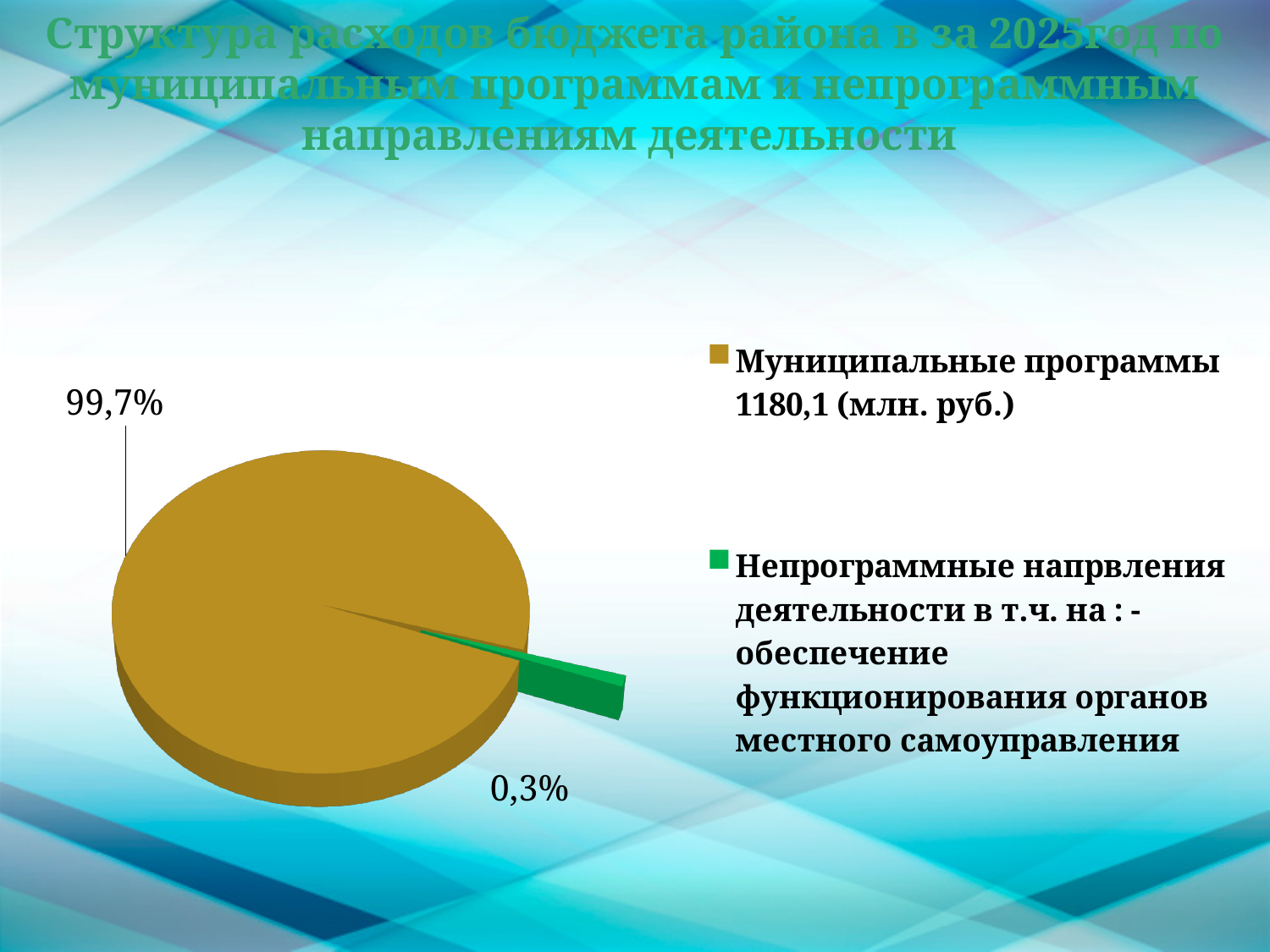
What share of the pie does the slice for "Муниципальные программы" represent? 99,7% What kind of chart is shown on the slide? Pie chart What share of the pie does the slice for "Непрограммные напрвления деятельности" represent? 0,3% What colour is the slice for "Муниципальные программы"? Gold What colour is the slice for "Непрограммные напрвления деятельности"? Green Which is larger: the slice for "Муниципальные программы" or the slice for "Непрограммные напрвления деятельности"? Муниципальные программы How many entries does the legend list? 2 What is the difference in percentage points between the two slices of the pie? 99,4 Which slice of the pie is the largest? Муниципальные программы Which slice of the pie is the smallest? Непрограммные напрвления деятельности What amount in million rubles is given in the legend for "Муниципальные программы"? 1180,1 (млн. руб.) How many slices does the pie chart have? 2